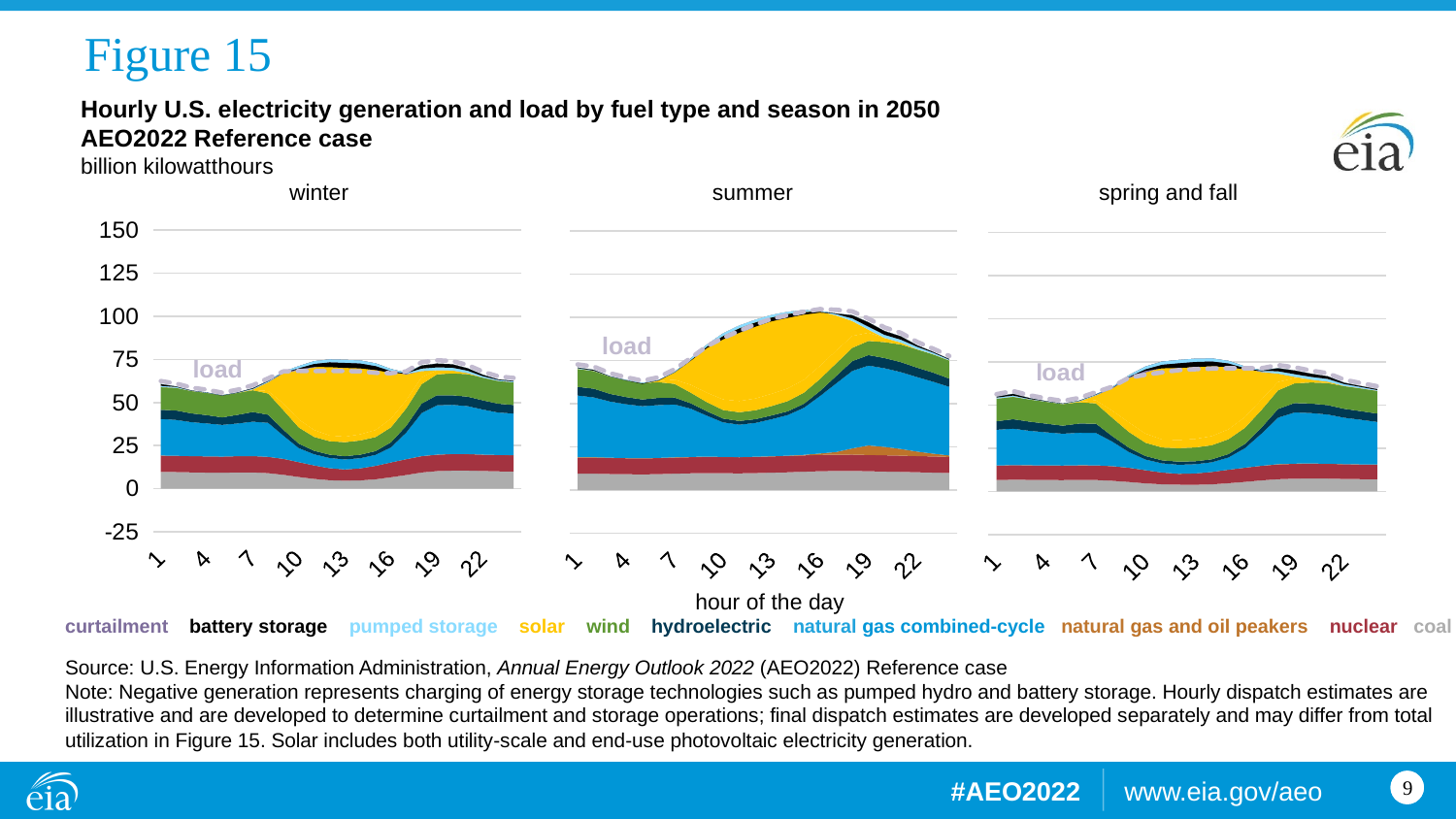
Comparing the winter and summer charts, which has the larger peak load? summer In the summer chart, is the peak load value greater or less than 75? greater In the summer chart, does the load rise or fall between hour 7 and hour 16? rise How many seasonal panels (charts) are shown on the slide? 3 How many fuel-type series does the legend at the bottom of the slide list? 10 What kind of chart is used in each of the three panels on this slide? stacked area chart What unit is used on the vertical axis of the charts? billion kilowatthours Which season's chart shows the highest peak load: winter, summer, or spring and fall? summer In the winter chart, is the total generation at hour 13 greater or less than 50? greater What is the label of the horizontal axis shared by the three charts? hour of the day In the spring and fall chart, is the load at hour 1 greater or less than 75? less